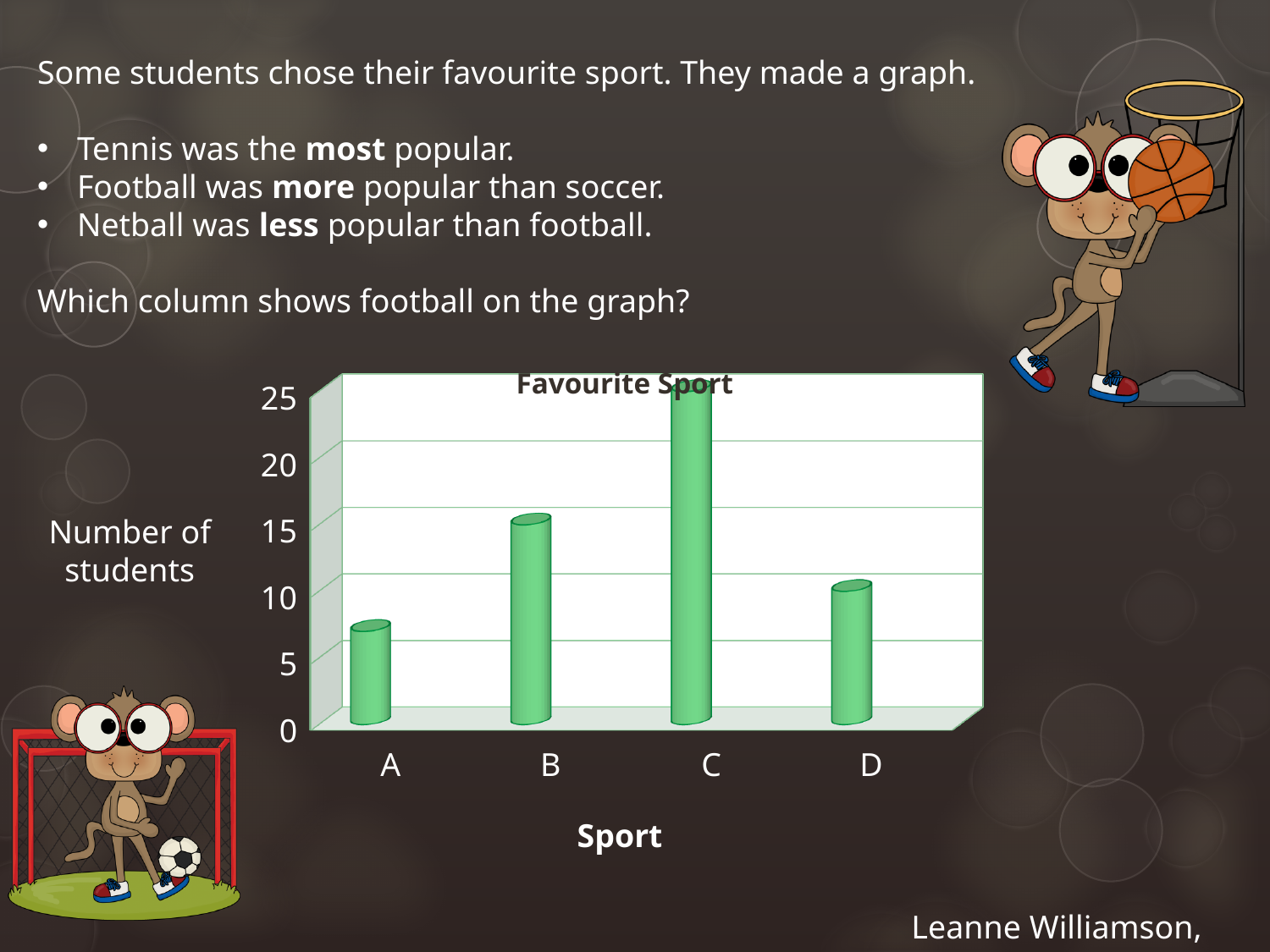
Which is larger, the value for B or the value for D? B How many categories are shown on the x axis of the chart? 4 Which is larger, the value for A or the value for C? C Which category has the lowest value in the chart? A What kind of chart is shown on the slide? bar chart Is the value for D greater or less than 15? less Which category has the highest value in the chart? C What is the title of the chart? Favourite Sport Is the value for C greater or less than 20? greater Is the value for A greater or less than 10? less What is the label of the x axis of the chart? Sport